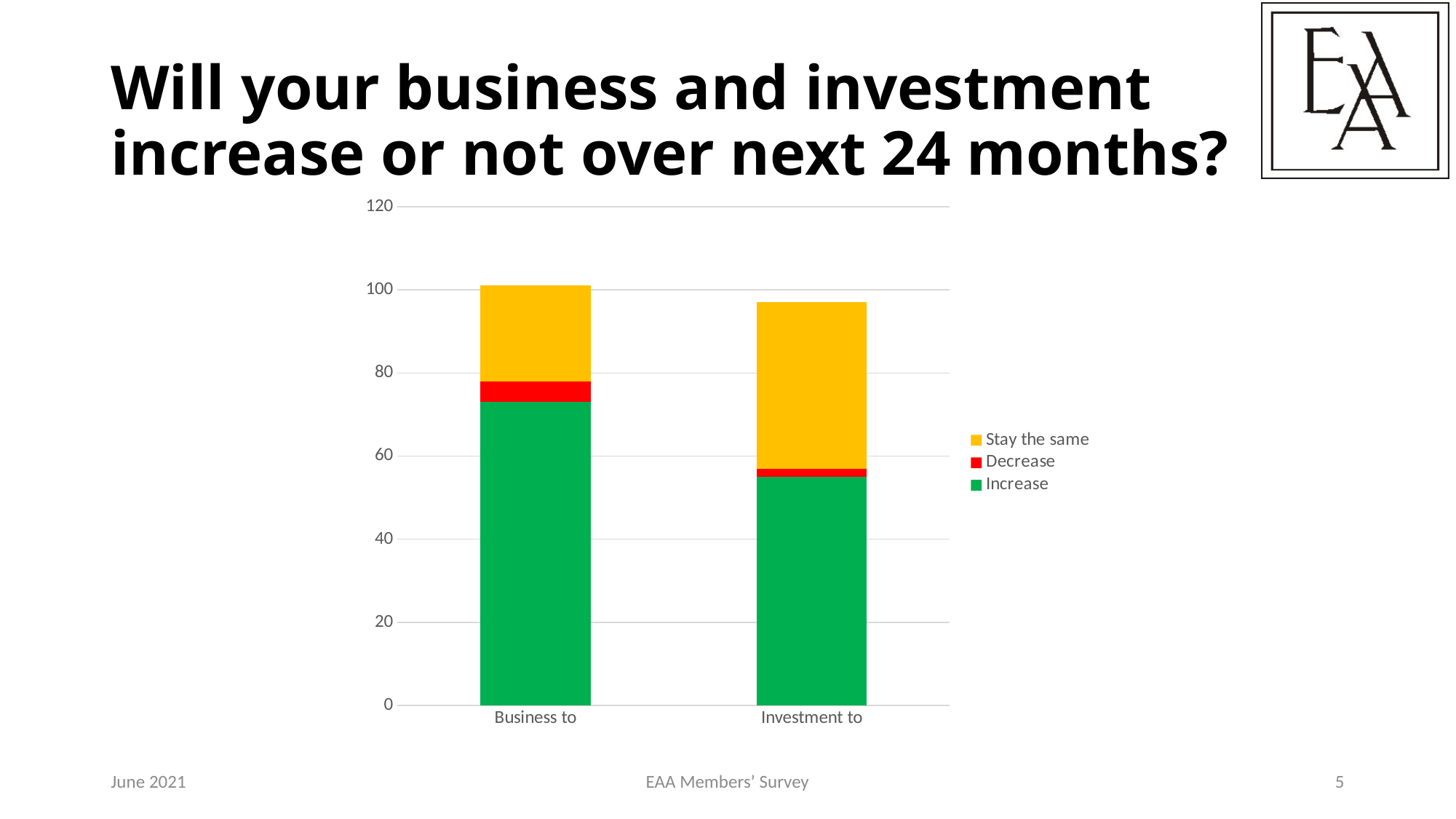
Which colour represents the Increase series in the chart? Green Which category has the taller stacked bar overall, Business to or Investment to? Business to Is the Increase value for Investment to greater or less than 40? greater Which colour represents the Decrease series in the chart? Red Is the Increase value for Business to greater or less than 60? greater Is the Increase segment larger for Business to or for Investment to? Business to How many categories are shown on the x axis of the chart? 2 Is the total height of the Investment to bar greater or less than 80? greater What kind of chart is shown on the slide? Stacked bar chart Is the Stay the same segment larger for Business to or for Investment to? Investment to How many series does the chart's legend list? 3